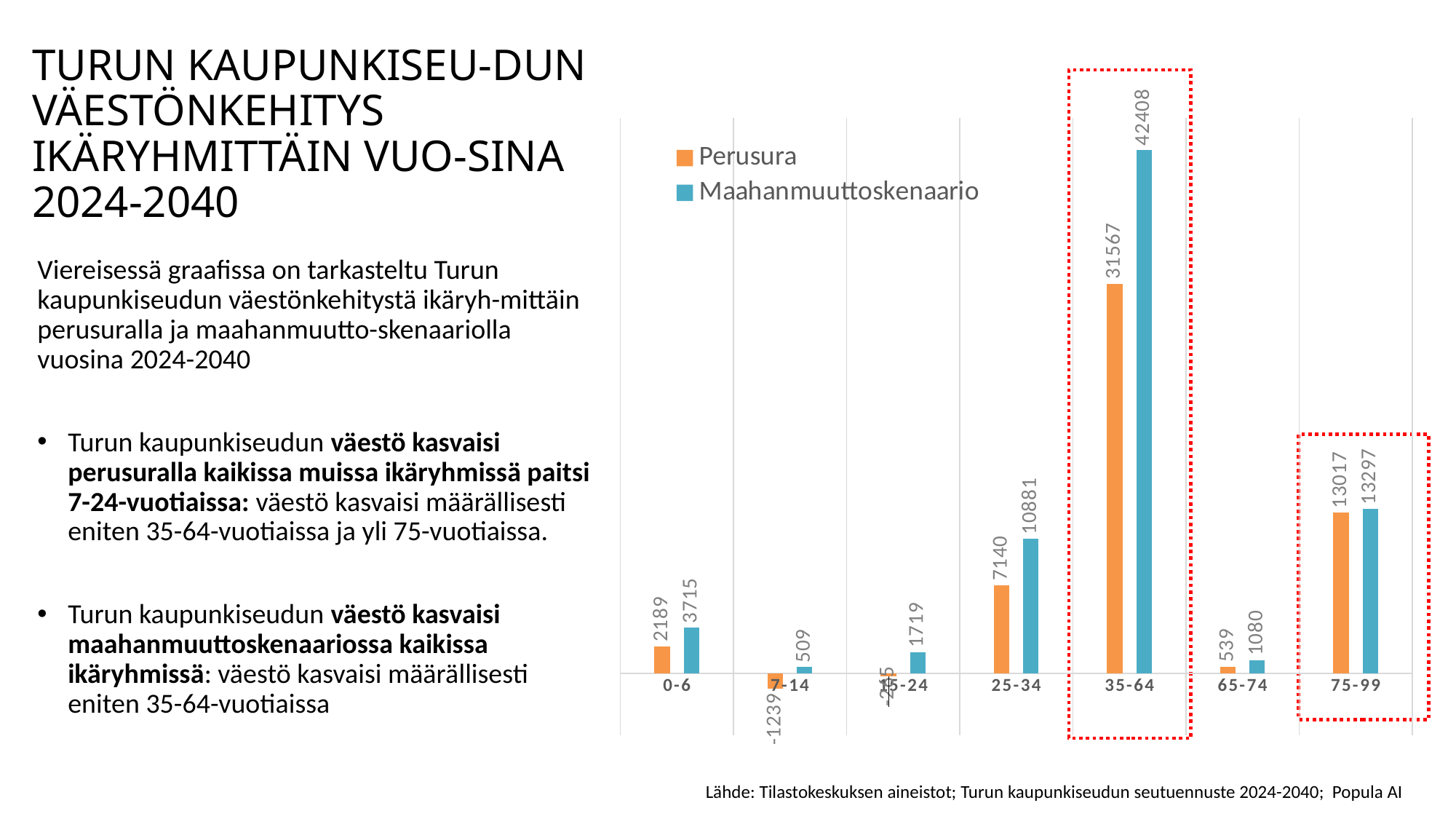
Which age group has the lowest Perusura value? 7-14 What is the Perusura value for the 7-14 age group? -1239 Which is larger for the 0-6 age group, the Perusura value or the Maahanmuuttoskenaario value? Maahanmuuttoskenaario What is the Perusura value for the 35-64 age group? 31567 What is the difference between the Maahanmuuttoskenaario and Perusura values for the 35-64 age group? 10841 How many series does the chart legend list? 2 Which colour represents the Perusura series in the chart? Orange Which age group has the highest Maahanmuuttoskenaario value? 35-64 How many age groups are shown on the x axis of the chart? 7 What kind of chart is shown on the slide? Bar chart What is the Maahanmuuttoskenaario value for the 75-99 age group? 13297 What is the Maahanmuuttoskenaario value for the 25-34 age group? 10881